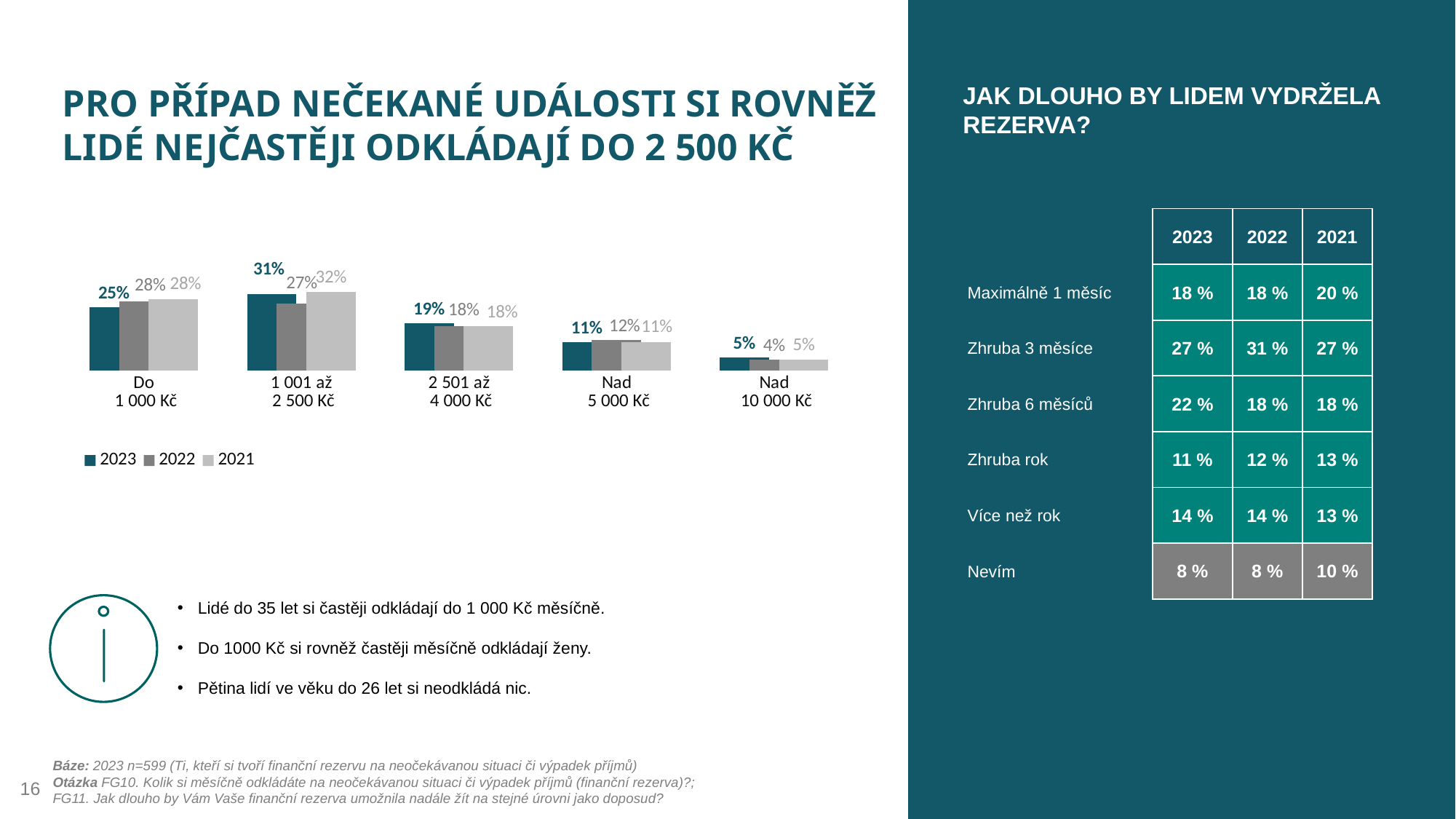
What is the difference between the 2023 and 2022 values for the category 'Do 1 000 Kč'? 3% What is the 2023 value for the category '1 001 až 2 500 Kč'? 31% For the category '1 001 až 2 500 Kč', which is larger: the 2023 value or the 2022 value? 2023 What kind of chart is shown on the left of the slide? Bar chart What is the 2021 value for the category 'Nad 10 000 Kč'? 5% Which category has the lowest 2022 value? Nad 10 000 Kč How many series does the chart legend list? 3 Do the 2023 values rise or fall from the category '1 001 až 2 500 Kč' to 'Nad 10 000 Kč'? Fall How many categories are shown on the x axis of the bar chart? 5 What is the 2023 value for the category '2 501 až 4 000 Kč'? 19% Which category has the highest 2023 value? 1 001 až 2 500 Kč What is the 2022 value for the category 'Do 1 000 Kč'? 28%